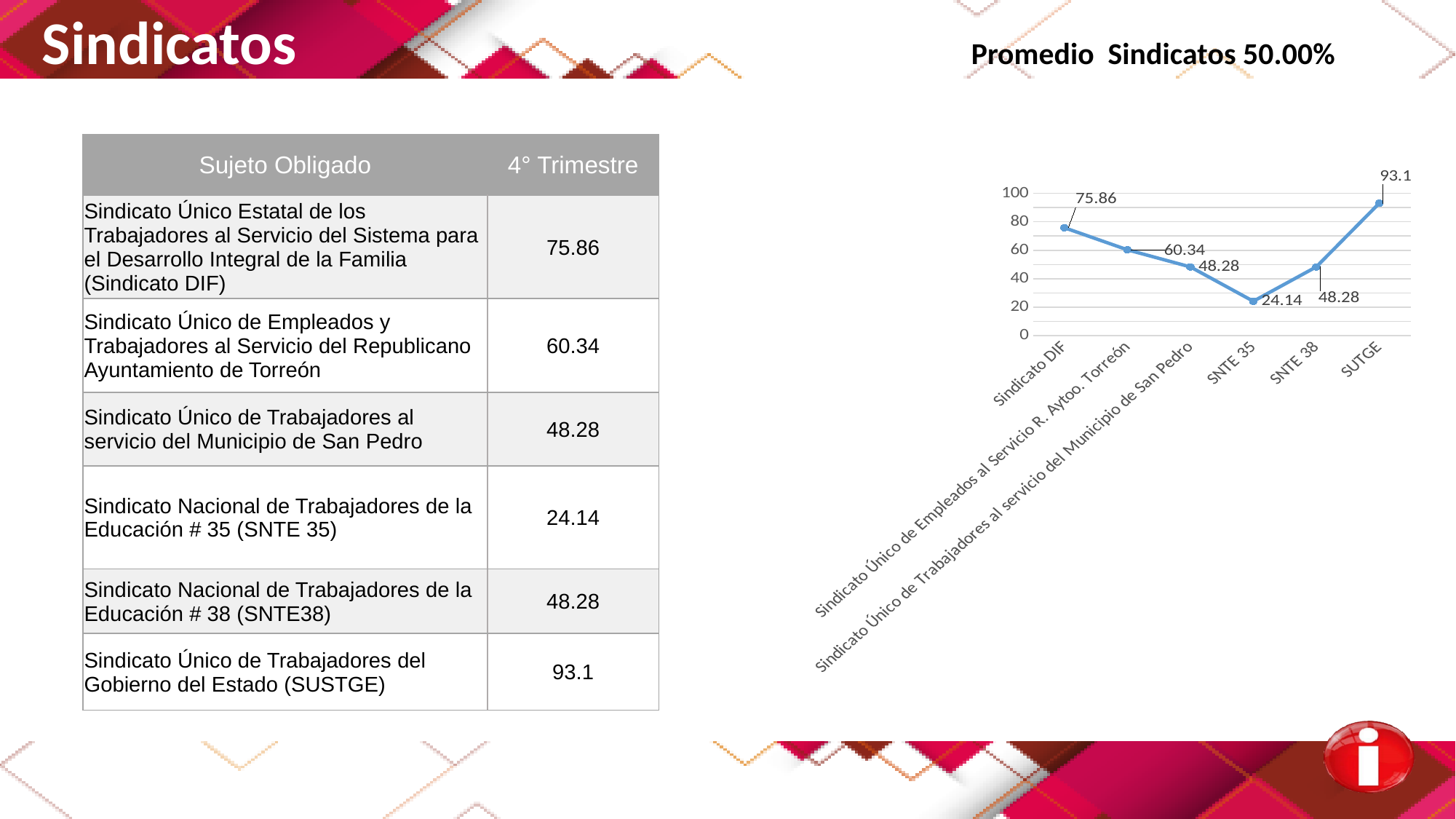
What is the difference between the values for Sindicato DIF and Sindicato Único de Empleados y Trabajadores al Servicio R. Aytoo. Torreón? 15.52 Which category has the lowest value in the chart? SNTE 35 Which is larger, the value for Sindicato DIF or the value for SNTE 38? Sindicato DIF What is the value for Sindicato DIF in the chart? 75.86 What is the value for SUTGE in the chart? 93.1 What is the difference between the values for SUTGE and SNTE 35? 68.96 Do the values rise or fall from Sindicato DIF to SNTE 35 along the x axis? fall What is the value for SNTE 38 in the chart? 48.28 Which category has the highest value in the chart? SUTGE What is the value for SNTE 35 in the chart? 24.14 How many categories are plotted in the chart? 6 What kind of chart is shown on the slide? line chart